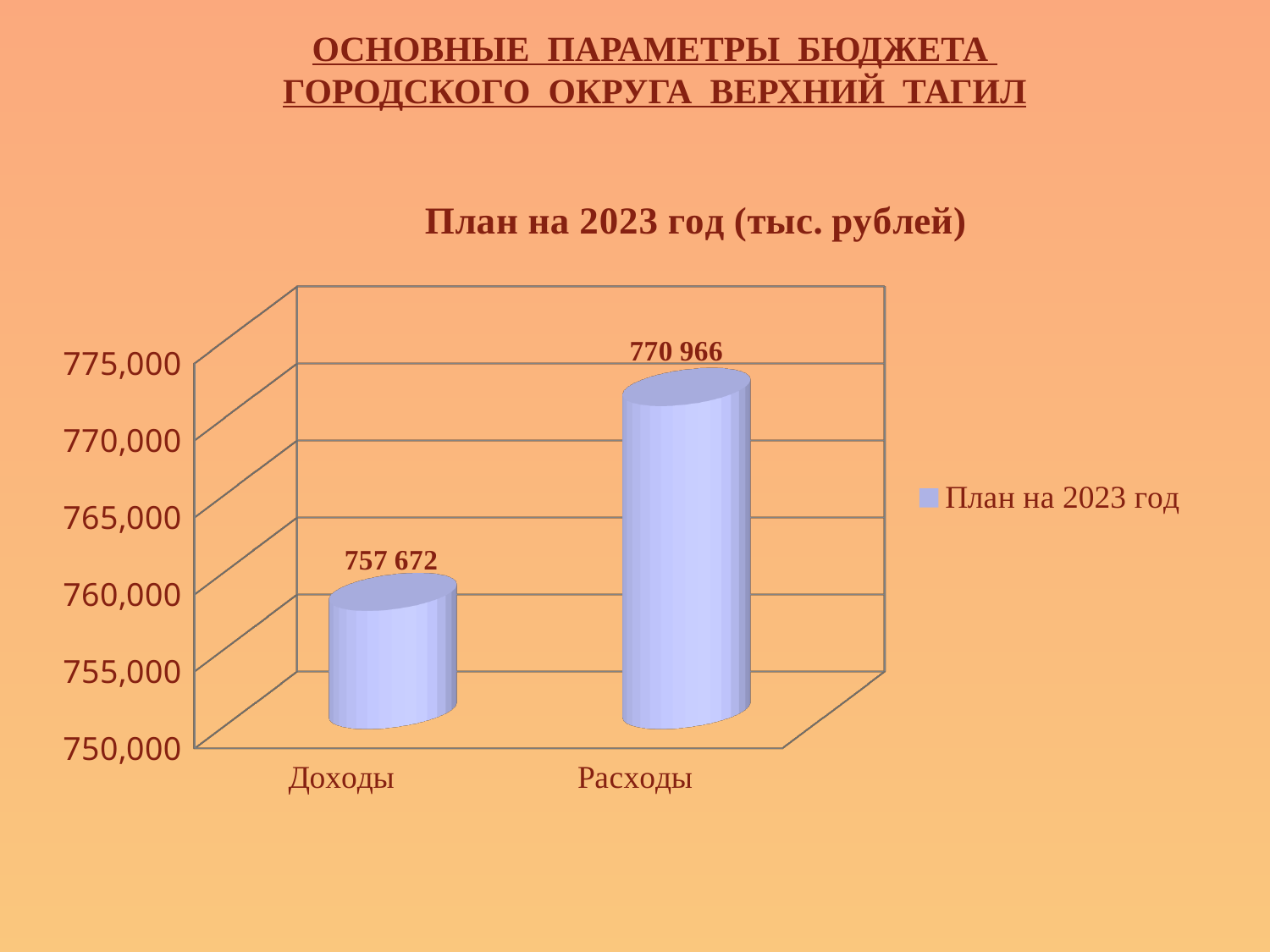
Which category has the highest value? Расходы What is the title of the chart? План на 2023 год (тыс. рублей) Which category has the lowest value? Доходы What is the value for Доходы? 757 672 Which is larger, the value for Доходы or the value for Расходы? Расходы How many series does the legend list? 1 Is the value for Расходы greater or less than 770,000? greater What is the value for Расходы? 770 966 What kind of chart is shown on the slide? bar chart Is the value for Доходы greater or less than 760,000? less How many categories are shown on the chart? 2 What is the difference between the values for Расходы and Доходы? 13 294